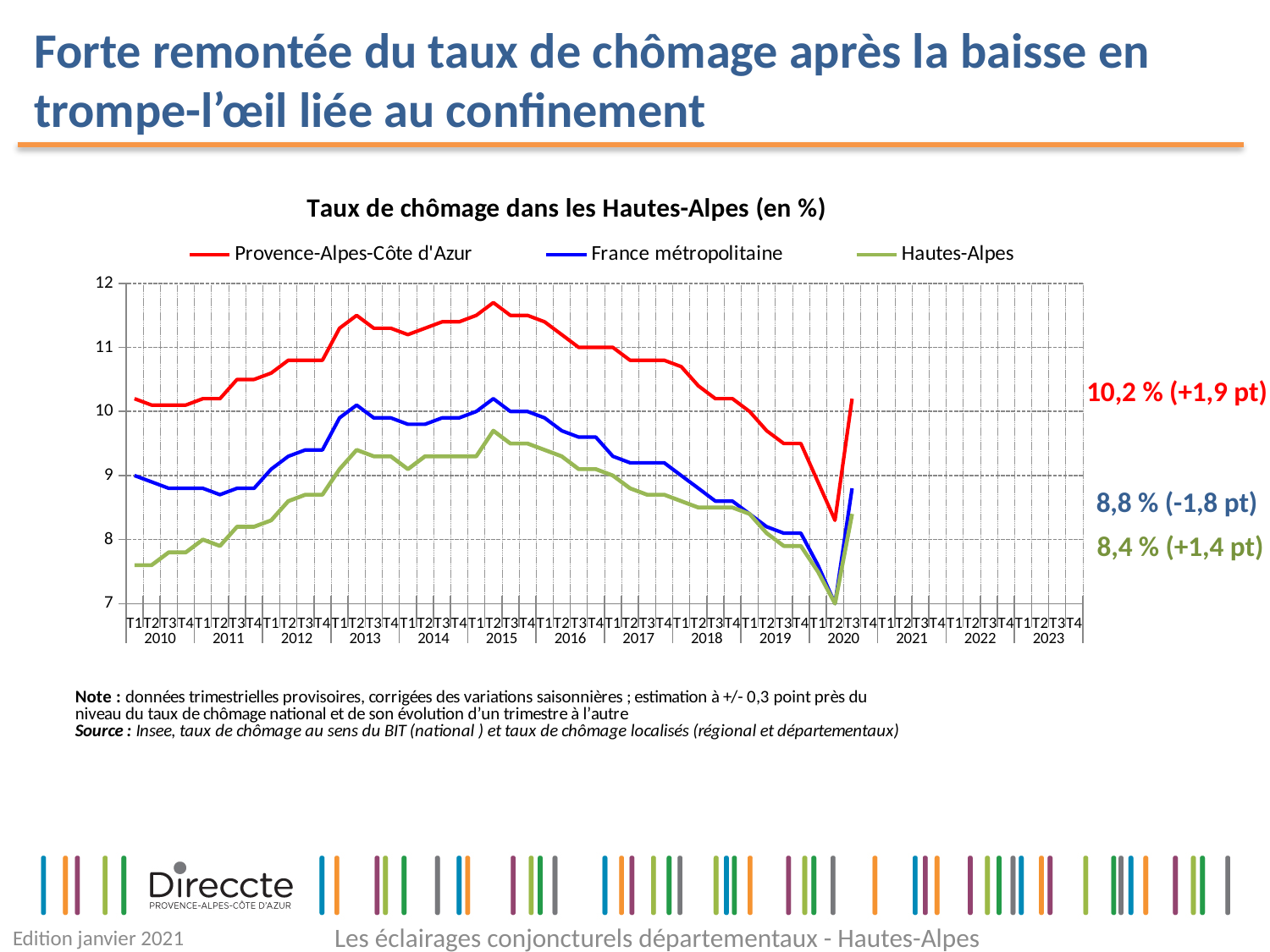
What is the latest unemployment rate shown for Hautes-Alpes? 8,4 % Is the Provence-Alpes-Côte d'Azur value in T2 2015 greater or less than 11? greater How many series does the legend list? 3 Which series has the highest value at the end of the chart? Provence-Alpes-Côte d'Azur Does the Provence-Alpes-Côte d'Azur line rise or fall between 2015 and 2019? fall Is the Hautes-Alpes value in T1 2010 greater or less than 8? less What is the latest unemployment rate shown for Provence-Alpes-Côte d'Azur? 10,2 % What is the latest unemployment rate shown for France métropolitaine? 8,8 % Which series has the lowest value at the end of the chart? Hautes-Alpes What kind of chart is shown on the slide? line chart What change in points is annotated next to the latest Hautes-Alpes value? +1,4 pt What is the difference between the latest Provence-Alpes-Côte d'Azur rate and the latest Hautes-Alpes rate? 1,8